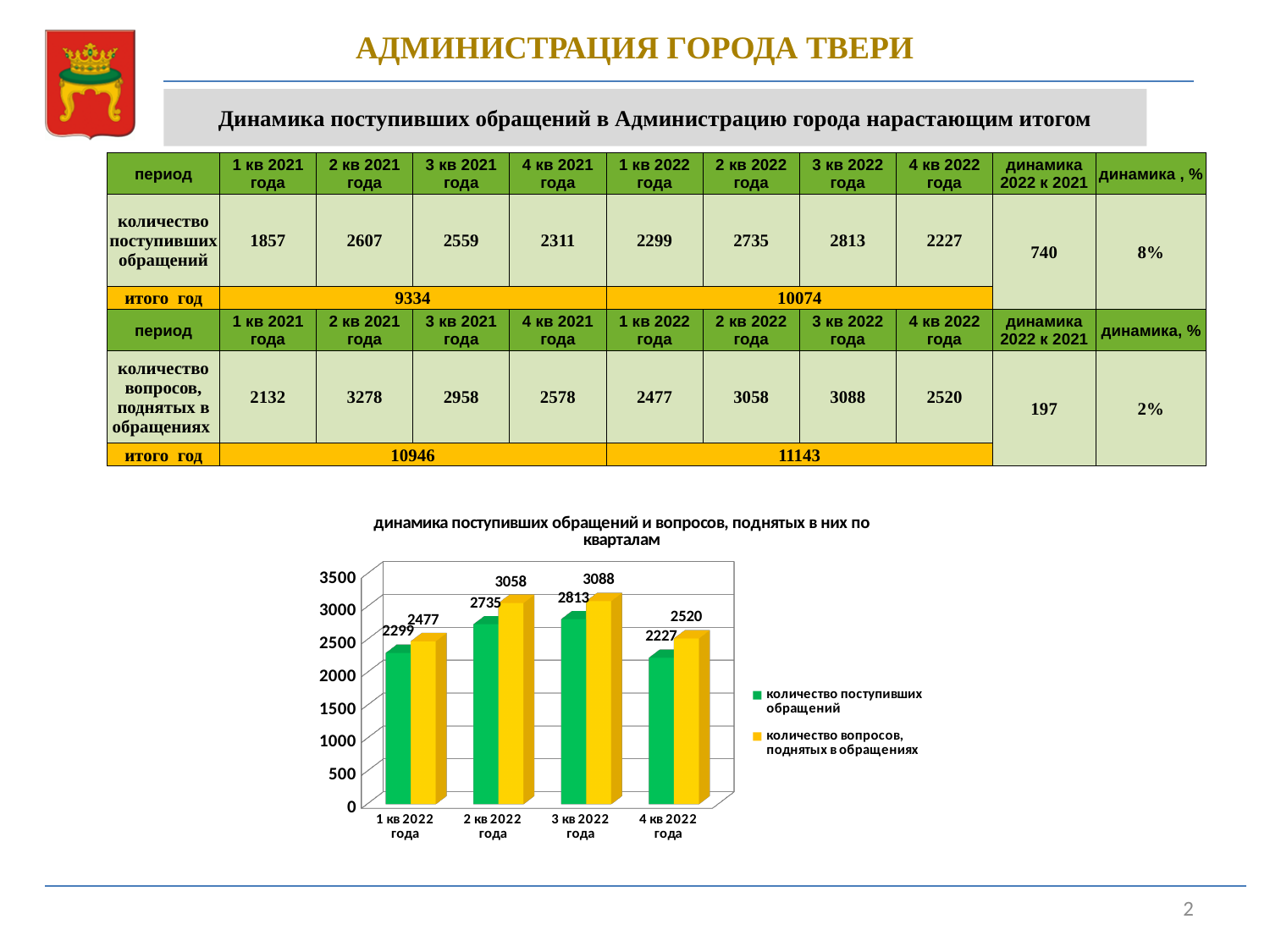
Is the value of 'количество вопросов, поднятых в обращениях' for 2 кв 2022 года greater or less than 3000? greater What is the value of 'количество поступивших обращений' for 1 кв 2022 года? 2299 What colour are the bars for 'количество поступивших обращений'? green What type of chart is shown on the slide? bar chart How many series does the chart legend list? 2 In which quarter is 'количество поступивших обращений' lowest? 4 кв 2022 года How many quarters are shown on the x axis of the chart? 4 Which is larger in 1 кв 2022 года: 'количество поступивших обращений' or 'количество вопросов, поднятых в обращениях'? количество вопросов, поднятых в обращениях What is the value of 'количество вопросов, поднятых в обращениях' for 3 кв 2022 года? 3088 What is the difference between 'количество вопросов, поднятых в обращениях' and 'количество поступивших обращений' in 2 кв 2022 года? 323 What is the value of 'количество вопросов, поднятых в обращениях' for 4 кв 2022 года? 2520 In which quarter is 'количество поступивших обращений' highest? 3 кв 2022 года